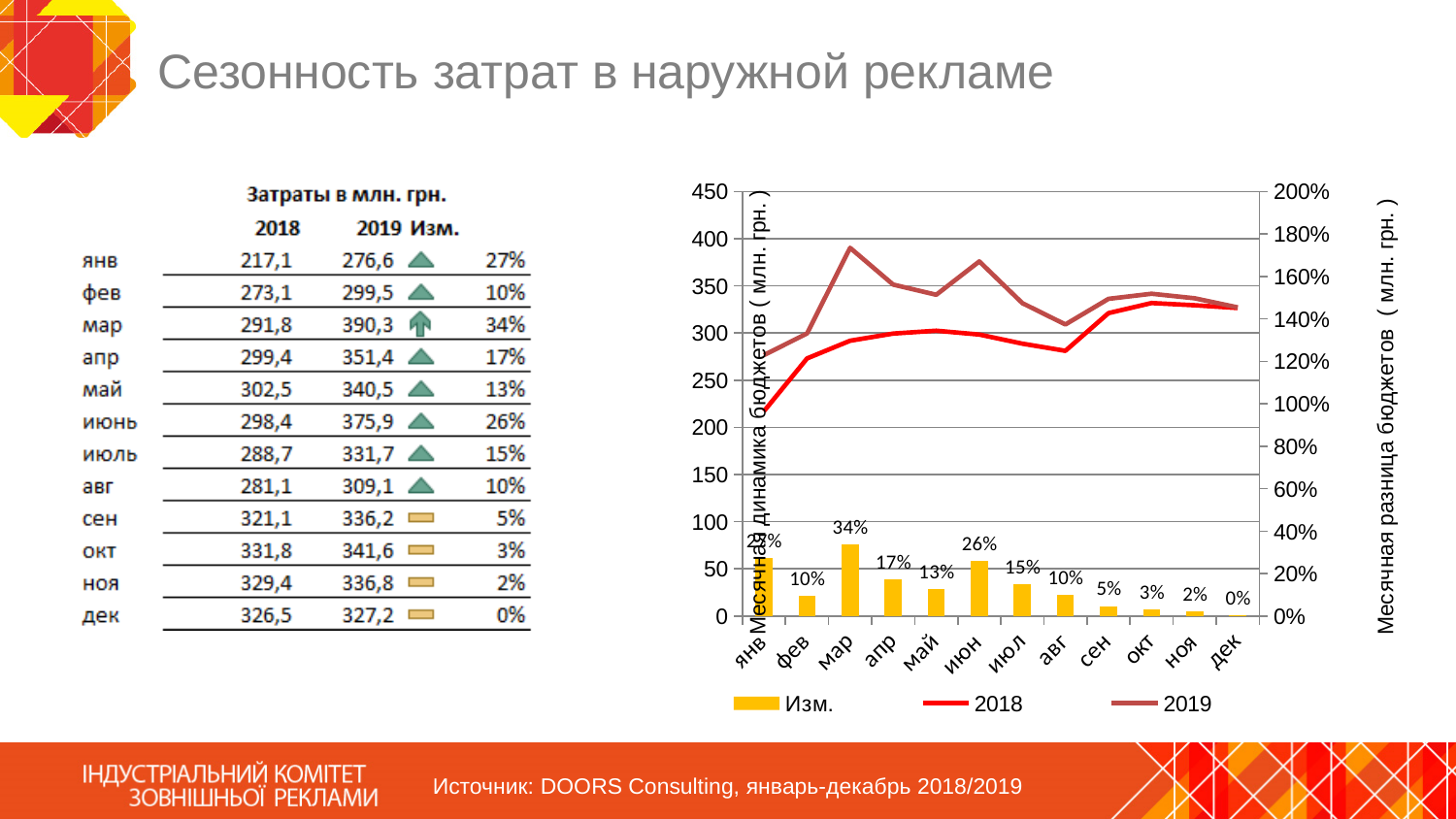
Is the value of the 2019 line for мар greater or less than 350? greater What is the difference between the Изм. values for мар and июн? 8% Which month has the lowest Изм. bar? дек Do the Изм. bars rise or fall from сен to дек? fall How many series does the chart legend list? 3 What is the value of the Изм. bar for июн? 26% What is the value of the Изм. bar for сен? 5% Is the value of the 2018 line for янв greater or less than 250? less What is the value of the Изм. bar for мар? 34% Which is larger, the Изм. value for апр or for май? апр Which month has the highest Изм. bar? мар How many months are shown on the x axis of the chart? 12